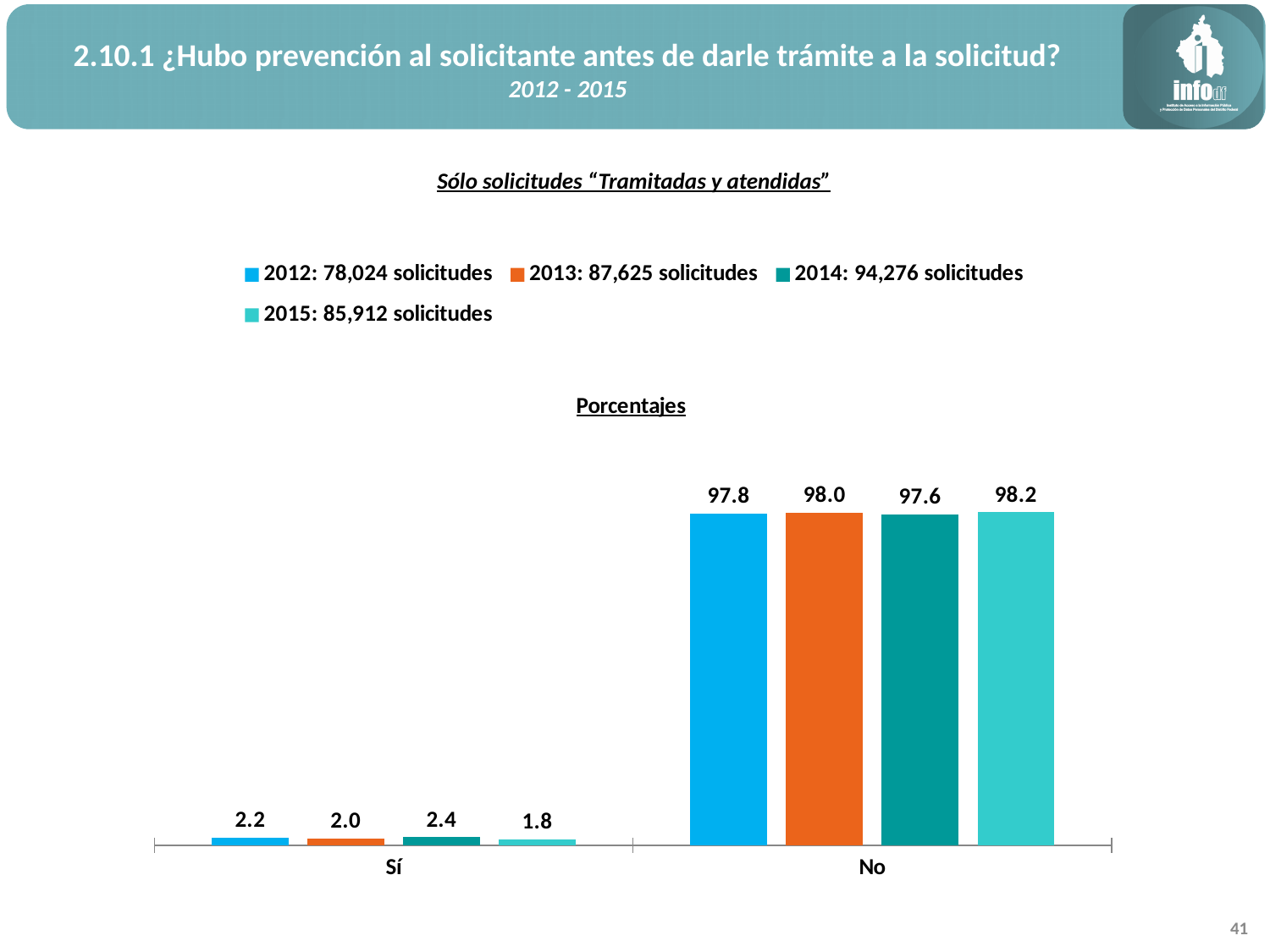
How many series does the legend list? 4 What is the value for "Sí" in the 2012 series? 2.2 According to the legend, how many solicitudes were there in 2014? 94,276 solicitudes Which year has the highest value for "Sí"? 2014 What is the value for "No" in the 2013 series? 98.0 What is the difference between the "No" values for 2015 and 2014? 0.6 What kind of chart is shown on the slide? Bar chart How many categories are shown on the x axis? 2 What is the value for "No" in the 2015 series? 98.2 Which year has the lowest value for "Sí"? 2015 What is the value for "Sí" in the 2014 series? 2.4 What is the difference between the "Sí" values for 2012 and 2013? 0.2